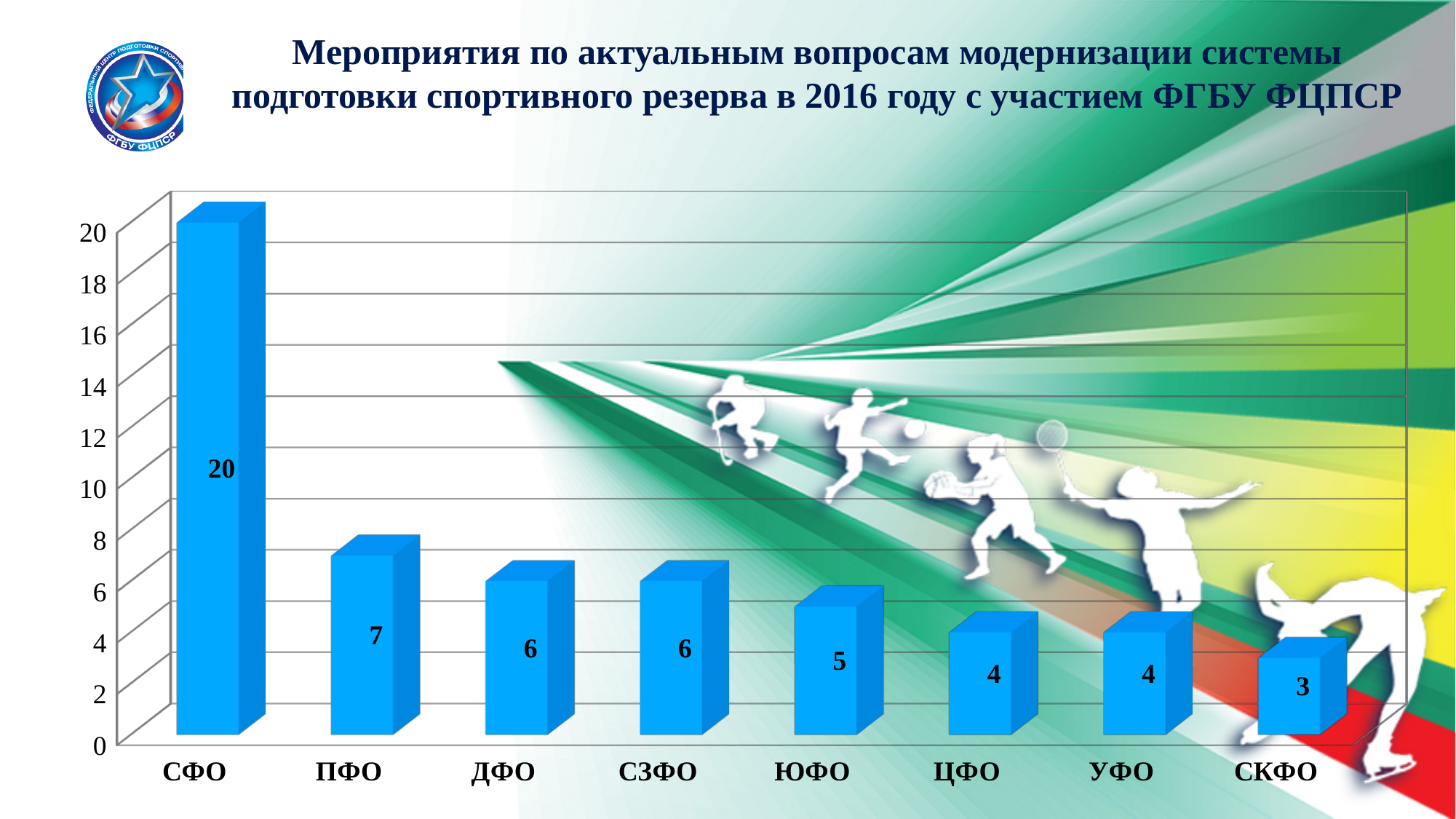
What is the value for ПФО? 7 How many categories are shown on the x axis? 8 Do the values rise or fall from left to right along the x axis? fall What is the value for СФО? 20 What is the value for ЮФО? 5 What is the difference between the values for СФО and ПФО? 13 What is the difference between the values for ЮФО and СКФО? 2 Which category has the highest value? СФО What kind of chart is shown on the slide? bar chart Which category has the lowest value? СКФО Which is larger, the value for ПФО or the value for ЦФО? ПФО What is the value for СКФО? 3